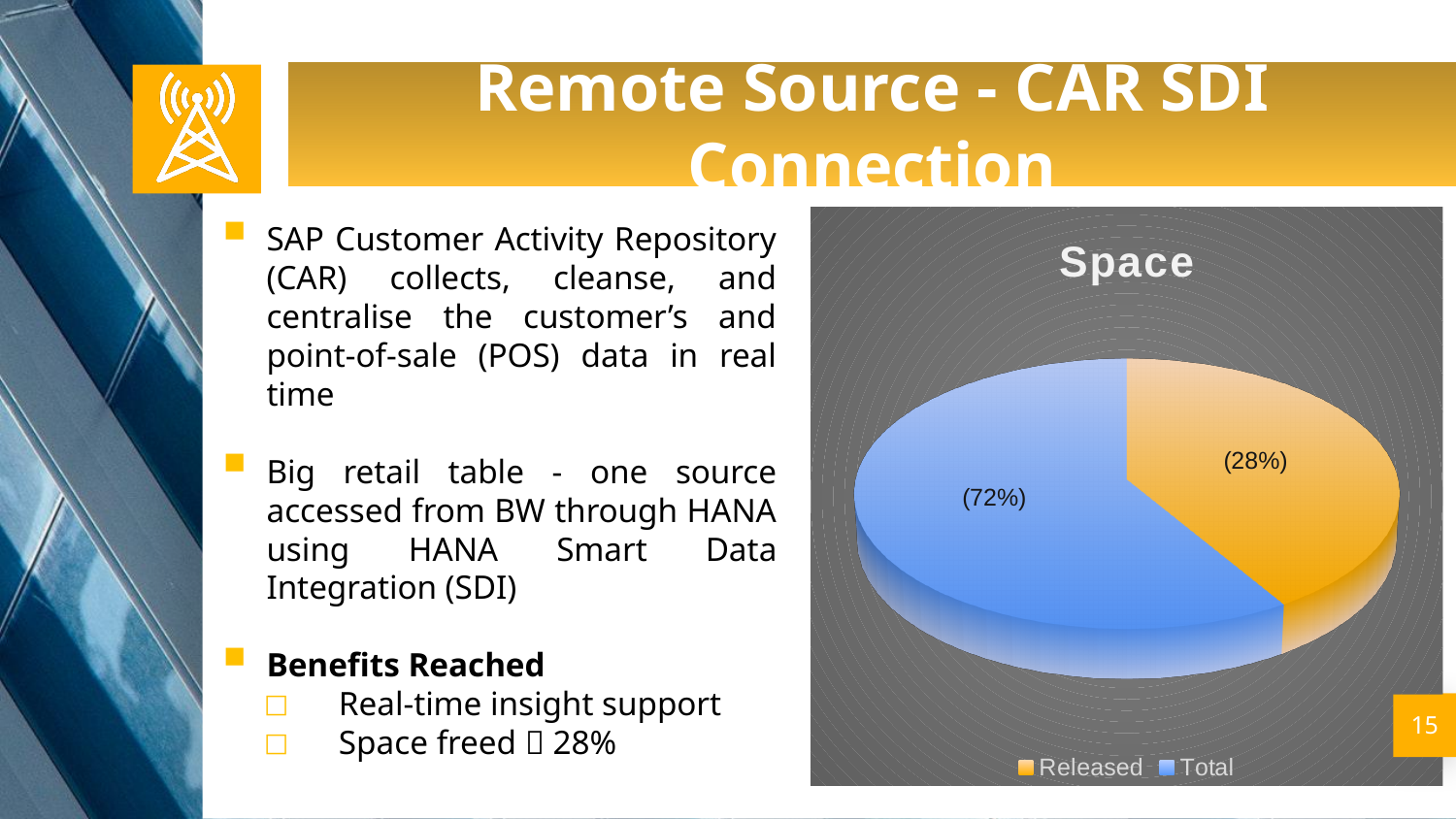
What type of chart is shown on the slide? pie chart Which slice of the pie is the smallest? Released What share of the pie does the Total slice represent? 72% What is the difference in percentage points between the Total slice and the Released slice? 44 What share of the pie does the Released slice represent? 28% Which is larger, the Released slice or the Total slice? Total How many slices does the pie chart have? 2 What colour is the Released slice in the pie chart? orange Which slice of the pie is the largest? Total What is the title of the chart? Space How many entries does the legend list? 2